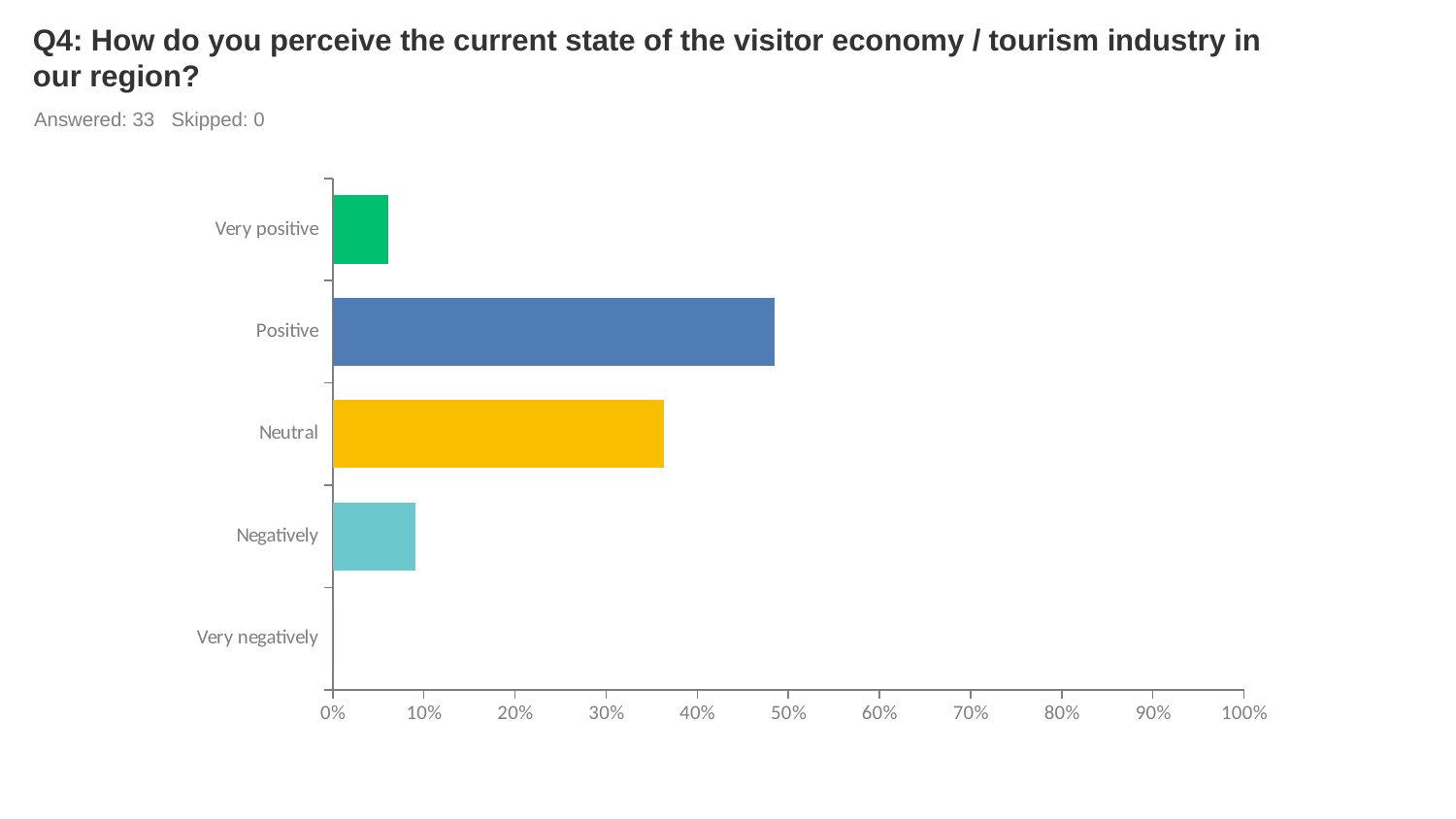
How many respondents answered this question according to the slide? 33 Which category has the highest value? Positive What is the value for Very negatively? 0% Is the value for Neutral greater or less than 40%? less Which is larger, the value for Positive or the value for Neutral? Positive Is the value for Very positive greater or less than 10%? less Is the value for Neutral greater or less than 30%? greater How many categories are shown on the chart? 5 What kind of chart is shown on the slide? bar chart Which category has the lowest value? Very negatively